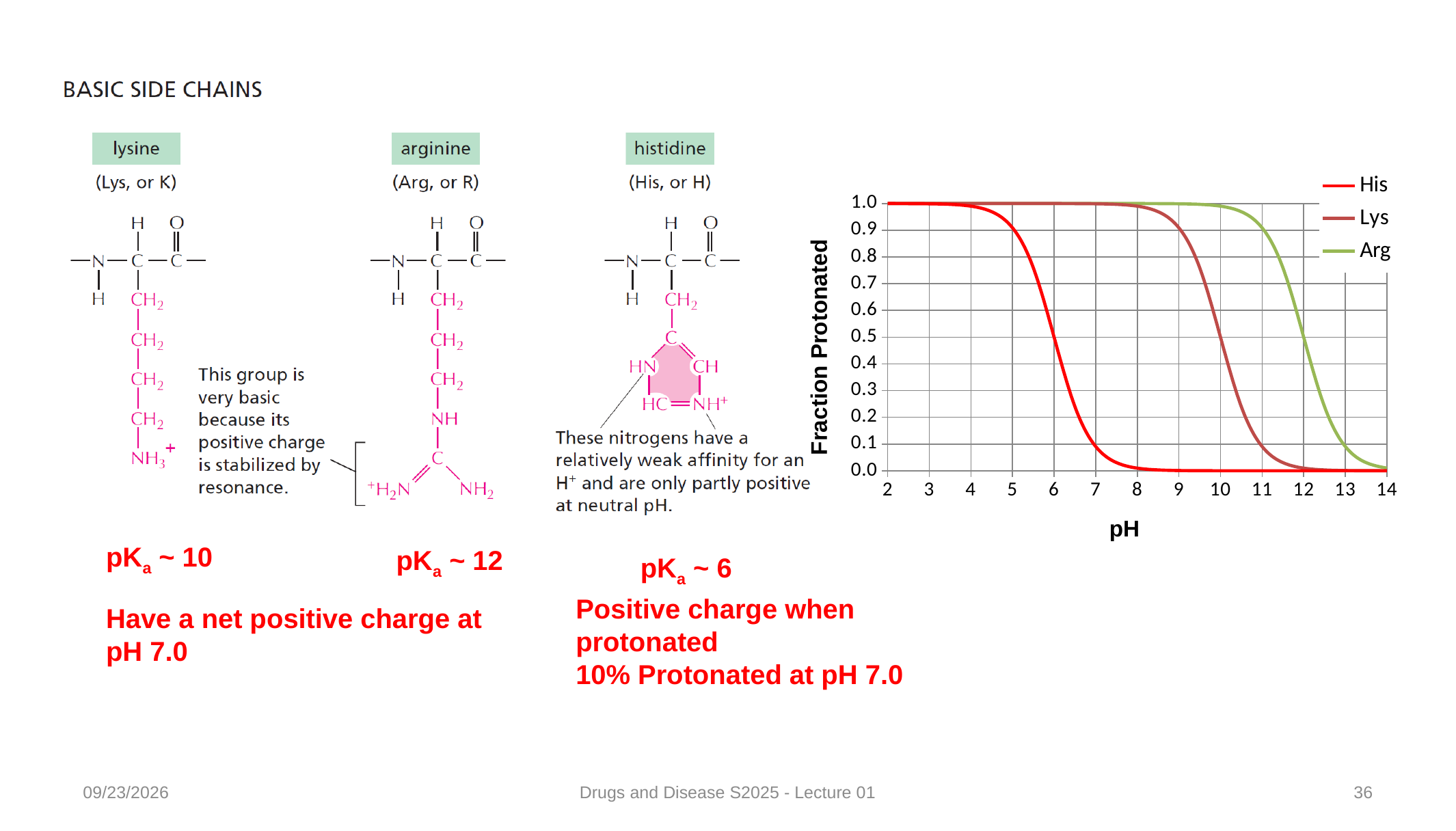
How many series does the legend of the Fraction Protonated chart list? 3 In the Fraction Protonated chart, do the curves rise or fall as pH increases? fall In the Fraction Protonated chart, is the Arg value at pH 10 greater or less than 0.9? greater In the Fraction Protonated chart, is the Lys value at pH 7 greater or less than 0.9? greater In the Fraction Protonated chart, is the His value at pH 8 greater or less than 0.1? less In the Fraction Protonated chart, which series has the higher fraction protonated at pH 6, His or Lys? Lys In the Fraction Protonated chart, which series drops to 0.5 fraction protonated at the lowest pH? His What are the three series named in the legend of the Fraction Protonated chart? His, Lys, Arg What is the label of the x axis of the Fraction Protonated chart? pH In the Fraction Protonated chart, which series has the higher fraction protonated at pH 10, Lys or Arg? Arg What kind of chart is shown on the right of the slide? line chart